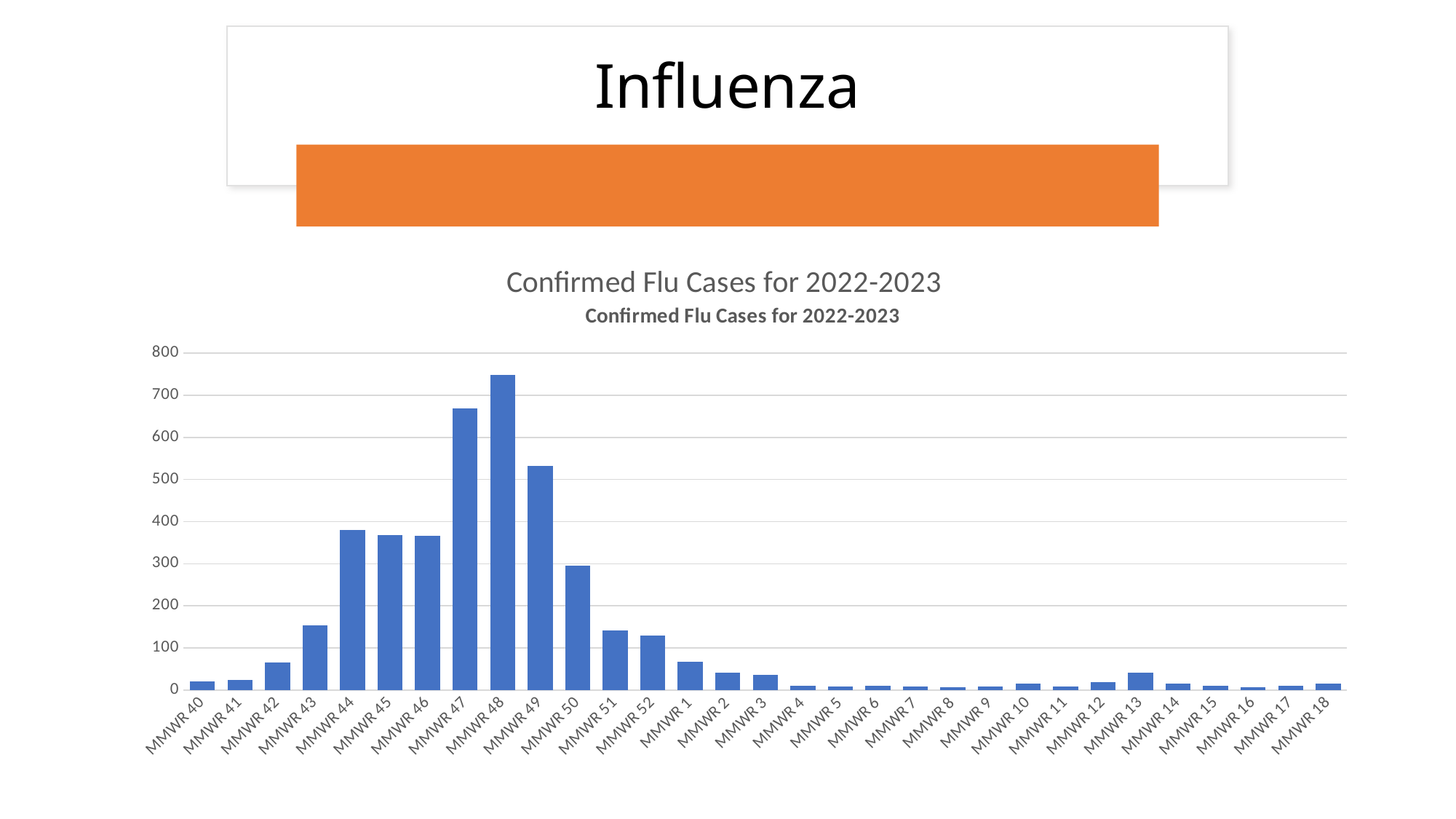
Which MMWR week has the highest number of confirmed flu cases? MMWR 48 What kind of chart is shown on the slide? bar chart How many MMWR week categories are shown on the x axis? 31 Is the value for MMWR 43 greater or less than 100? greater Which has more confirmed flu cases, MMWR 47 or MMWR 49? MMWR 47 Do the values rise or fall from MMWR 48 to MMWR 52? fall Is the value for MMWR 48 greater or less than 700? greater Is the value for MMWR 47 greater or less than 600? greater Which has more confirmed flu cases, MMWR 13 or MMWR 16? MMWR 13 What is the title of the chart? Confirmed Flu Cases for 2022-2023